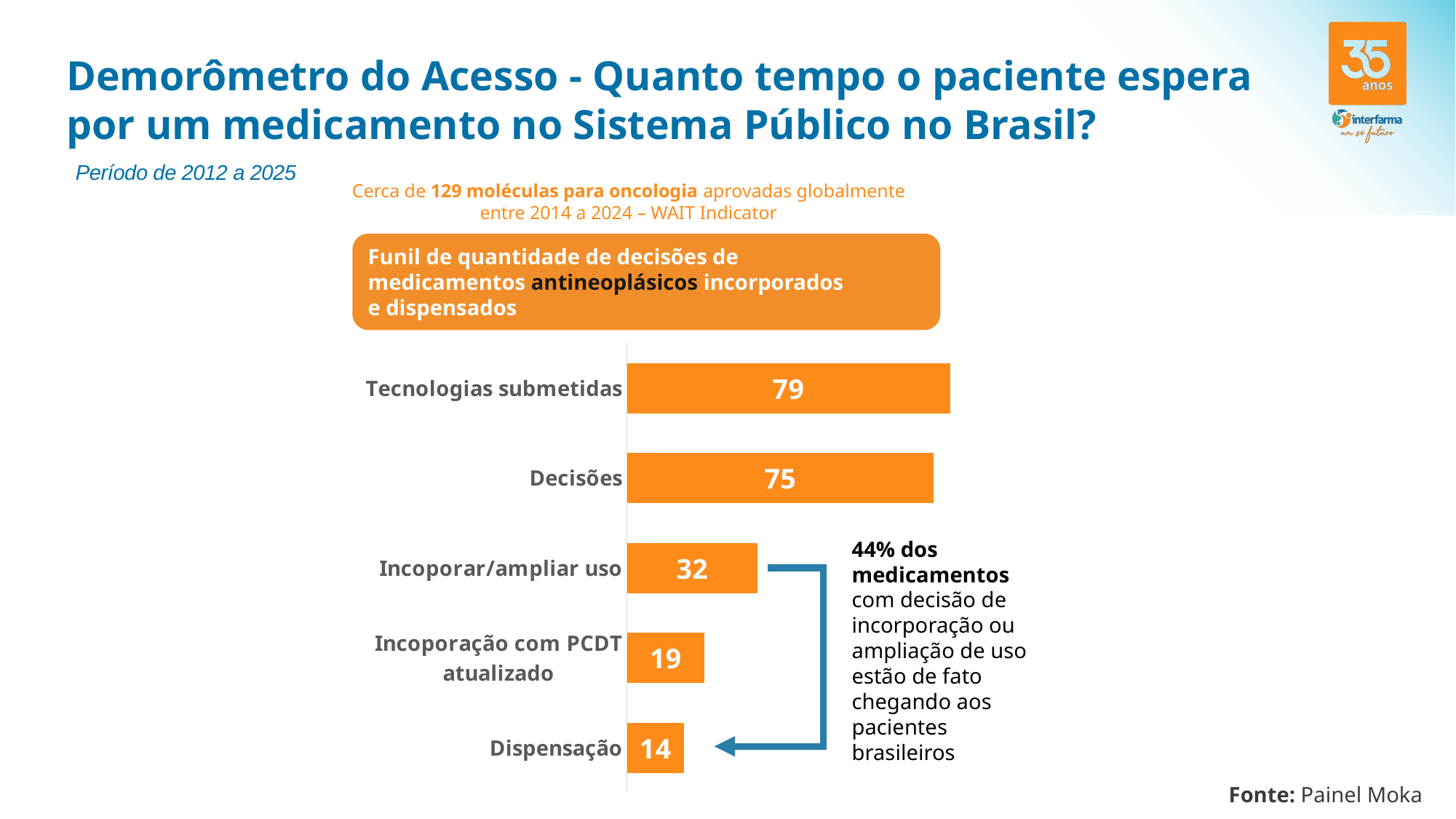
What is the difference between Tecnologias submetidas and Decisões? 4 What is the value for Decisões? 75 Which category has the highest value? Tecnologias submetidas Which is larger, Incoporação com PCDT atualizado or Dispensação? Incoporação com PCDT atualizado What is the value for Tecnologias submetidas? 79 What is the value for Dispensação? 14 What is the difference between Incoporar/ampliar uso and Dispensação? 18 Which category has the lowest value? Dispensação How many categories are shown in the chart? 5 What is the value for Incoporar/ampliar uso? 32 What kind of chart is shown on the slide? Bar chart What is the value for Incoporação com PCDT atualizado? 19